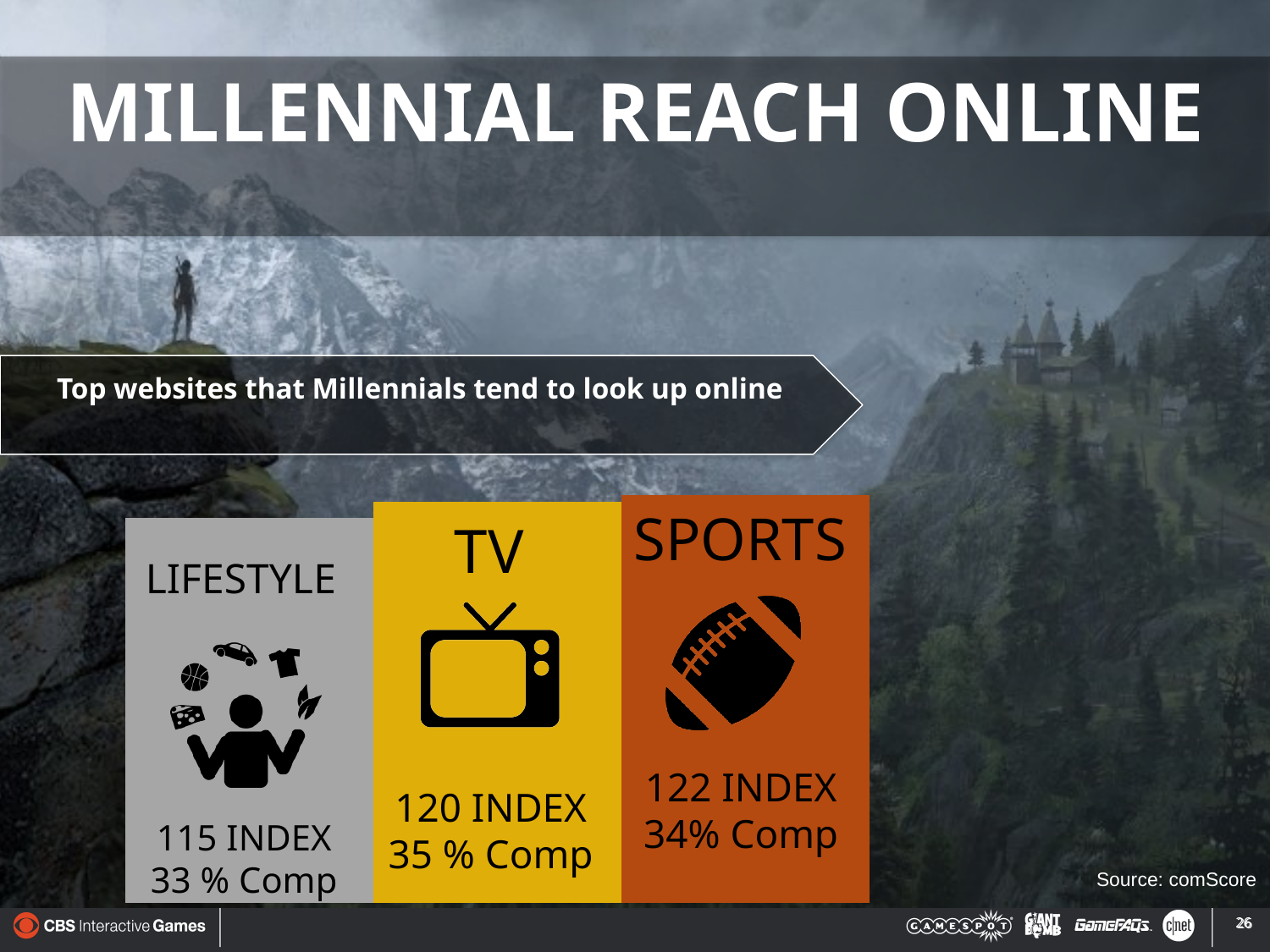
What is the index value shown for Sports? 122 Which category has the highest index value? Sports What % Comp value is shown for TV? 35 % What is the index value shown for TV? 120 Which category has the lowest index value? Lifestyle What is the difference between the Sports index and the Lifestyle index? 7 What is the index value shown for Lifestyle? 115 Which category has the highest % Comp value? TV Which has a higher index value, TV or Sports? Sports What % Comp value is shown for Lifestyle? 33 % How many website categories are shown in the graphic? 3 What % Comp value is shown for Sports? 34%